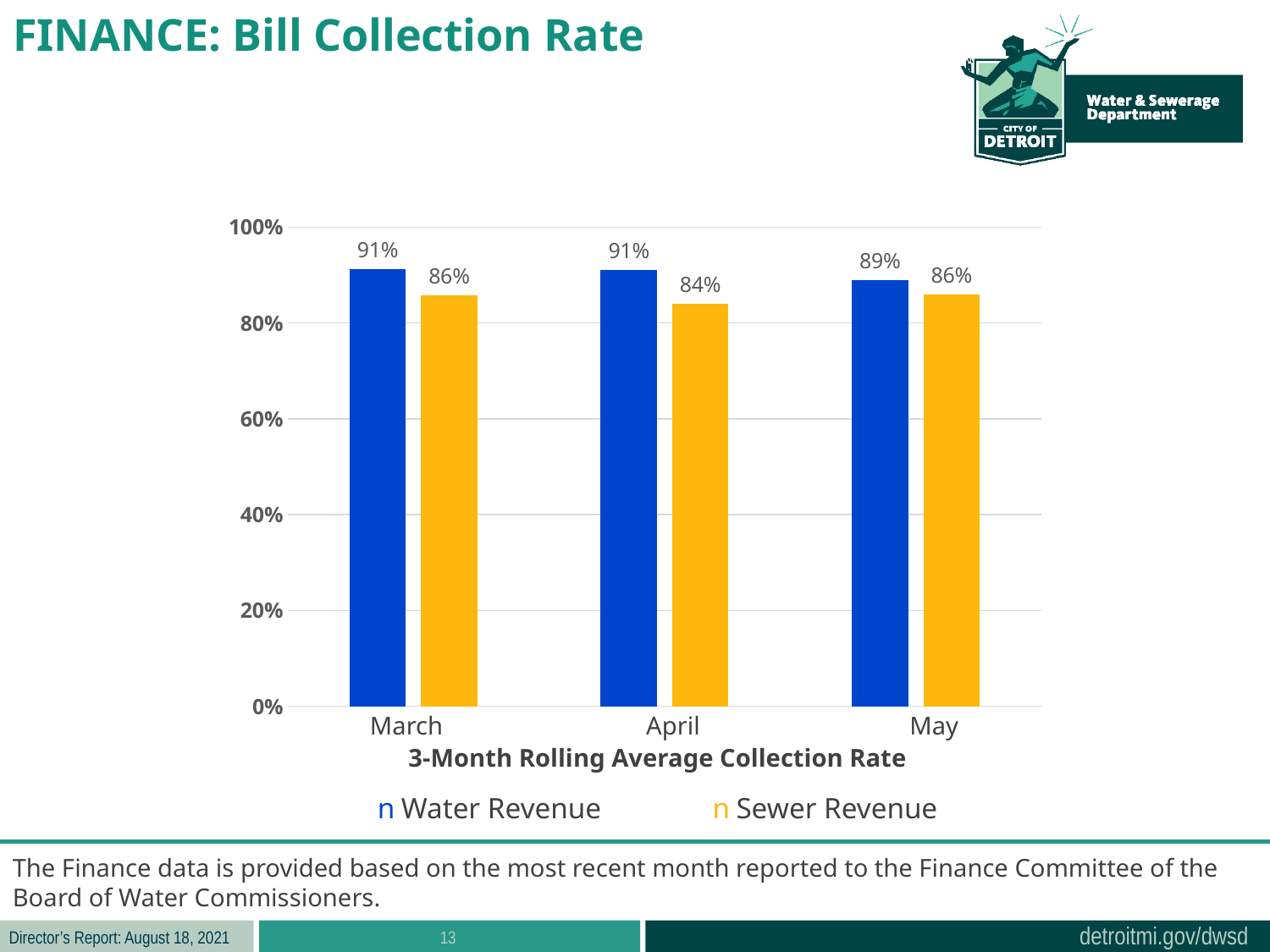
How many series does the legend list? 2 What is the Sewer Revenue collection rate for May? 86% What is the difference between the Water Revenue and Sewer Revenue collection rates in April? 7% What kind of chart is shown on the slide? Bar chart Which month has the lowest Sewer Revenue collection rate? April What is the Water Revenue collection rate for March? 91% How many months are shown on the x axis? 3 Which is larger in March, the Water Revenue or the Sewer Revenue collection rate? Water Revenue Is the Sewer Revenue collection rate for April greater or less than 80%? greater What is the Sewer Revenue collection rate for April? 84% Which month has the lowest Water Revenue collection rate? May What is the Water Revenue collection rate for May? 89%